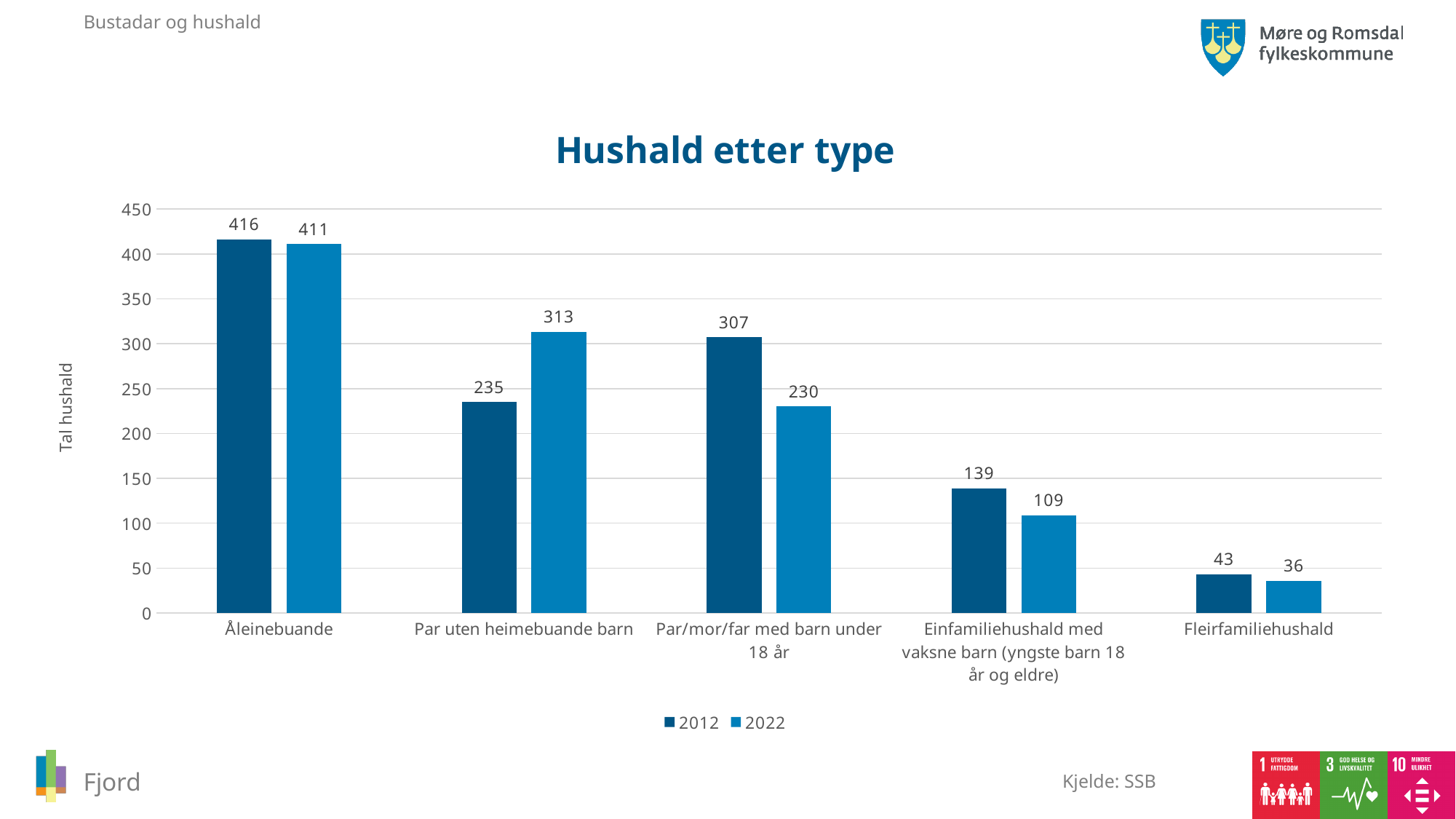
What is the difference between the 2012 and 2022 values for Par/mor/far med barn under 18 år? 77 What is the value for Åleinebuande in 2012? 416 How many categories are shown on the x axis? 5 What is the difference between the 2012 and 2022 values for Einfamiliehushald med vaksne barn (yngste barn 18 år og eldre)? 30 What is the value for Par uten heimebuande barn in 2022? 313 What kind of chart is shown? Bar chart Which category has the lowest value in 2012? Fleirfamiliehushald Which category has the highest value in 2022? Åleinebuande Which is larger for Par uten heimebuande barn: the 2012 value or the 2022 value? 2022 How many series does the legend list? 2 What is the value for Fleirfamiliehushald in 2022? 36 What is the title of the chart? Hushald etter type